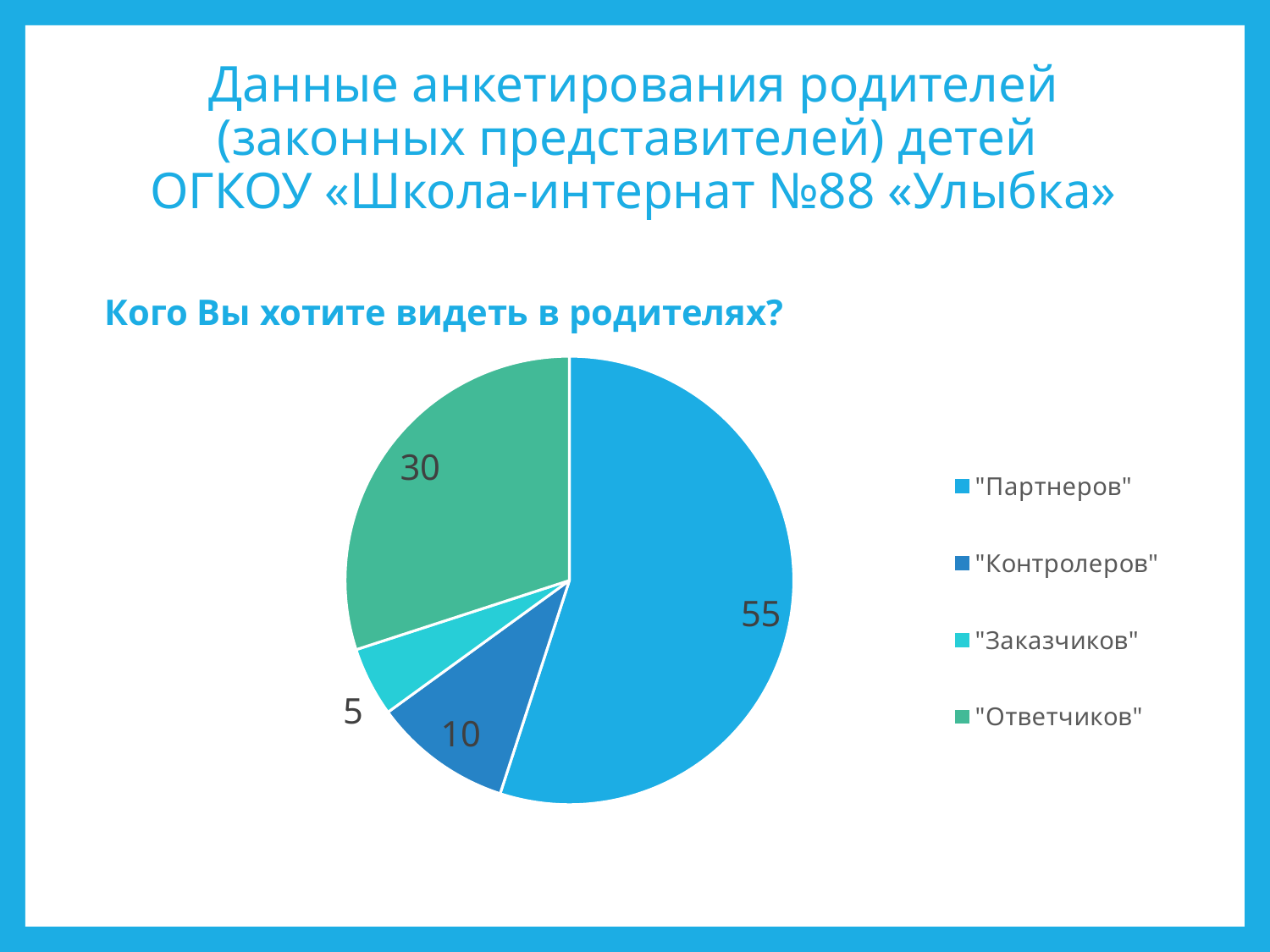
What is the title of the chart? Кого Вы хотите видеть в родителях? What kind of chart is shown on the slide? pie chart Which category has the largest slice? "Партнеров" Which is larger, the value for "Контролеров" or the value for "Заказчиков"? "Контролеров" What is the difference between the values for "Партнеров" and "Ответчиков"? 25 What is the value for "Заказчиков"? 5 What is the value for "Контролеров"? 10 What share of the pie does "Ответчиков" represent? 30% What is the value for "Ответчиков"? 30 What is the value for "Партнеров"? 55 Which category has the smallest slice? "Заказчиков" How many slices does the pie chart have? 4